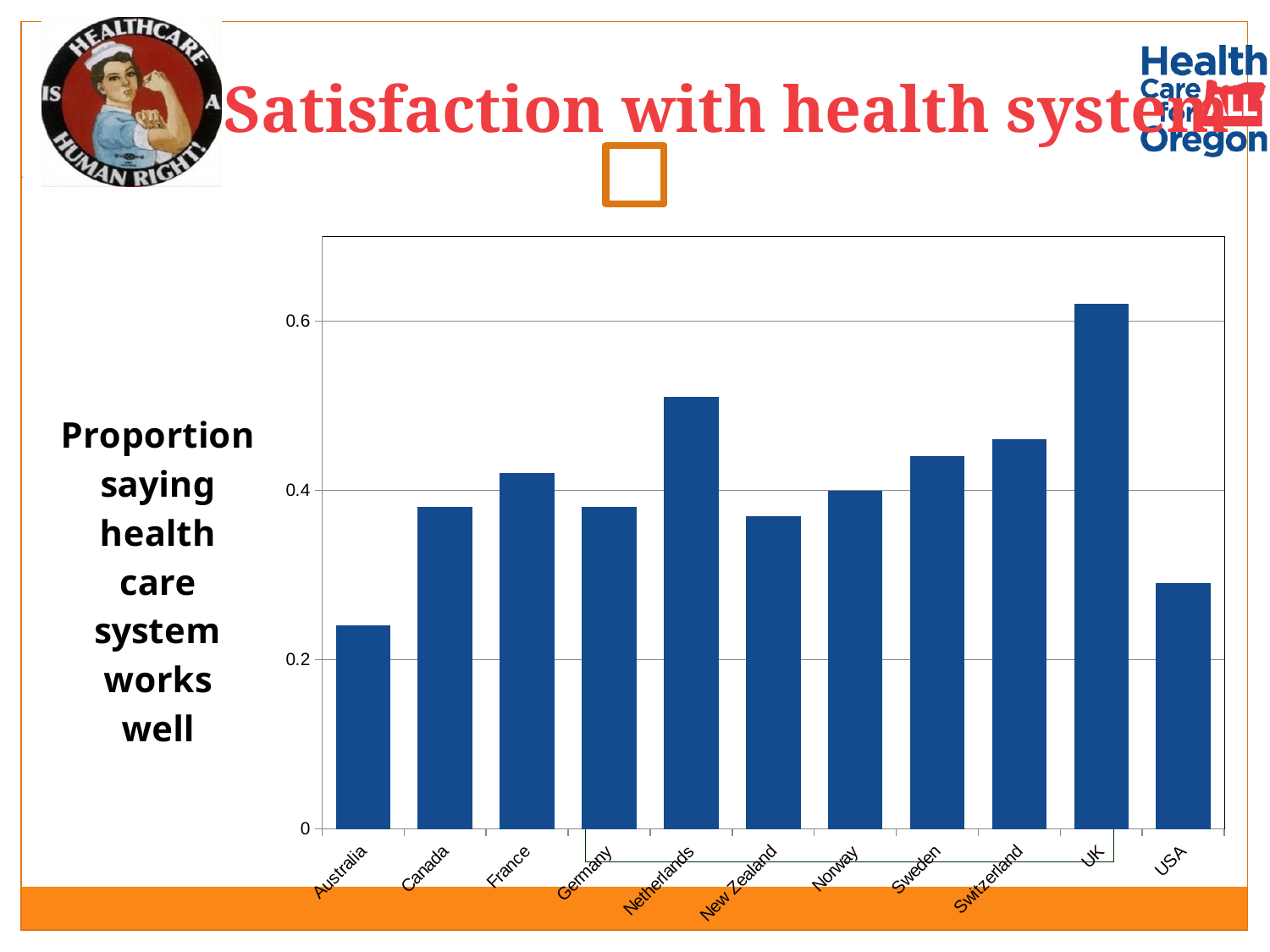
Is the value for the Netherlands greater or less than 0.4? greater Is the value for the USA greater or less than 0.4? less Is the value for New Zealand greater or less than 0.4? less Which country has the lowest proportion saying the health care system works well? Australia Which has a higher value, the Netherlands or Canada? Netherlands Which country has the highest proportion saying the health care system works well? UK What is the title of the slide containing the chart? Satisfaction with health system Which has a higher value, the USA or Australia? USA What kind of chart is shown on the slide? bar chart How many countries are shown on the x axis of the chart? 11